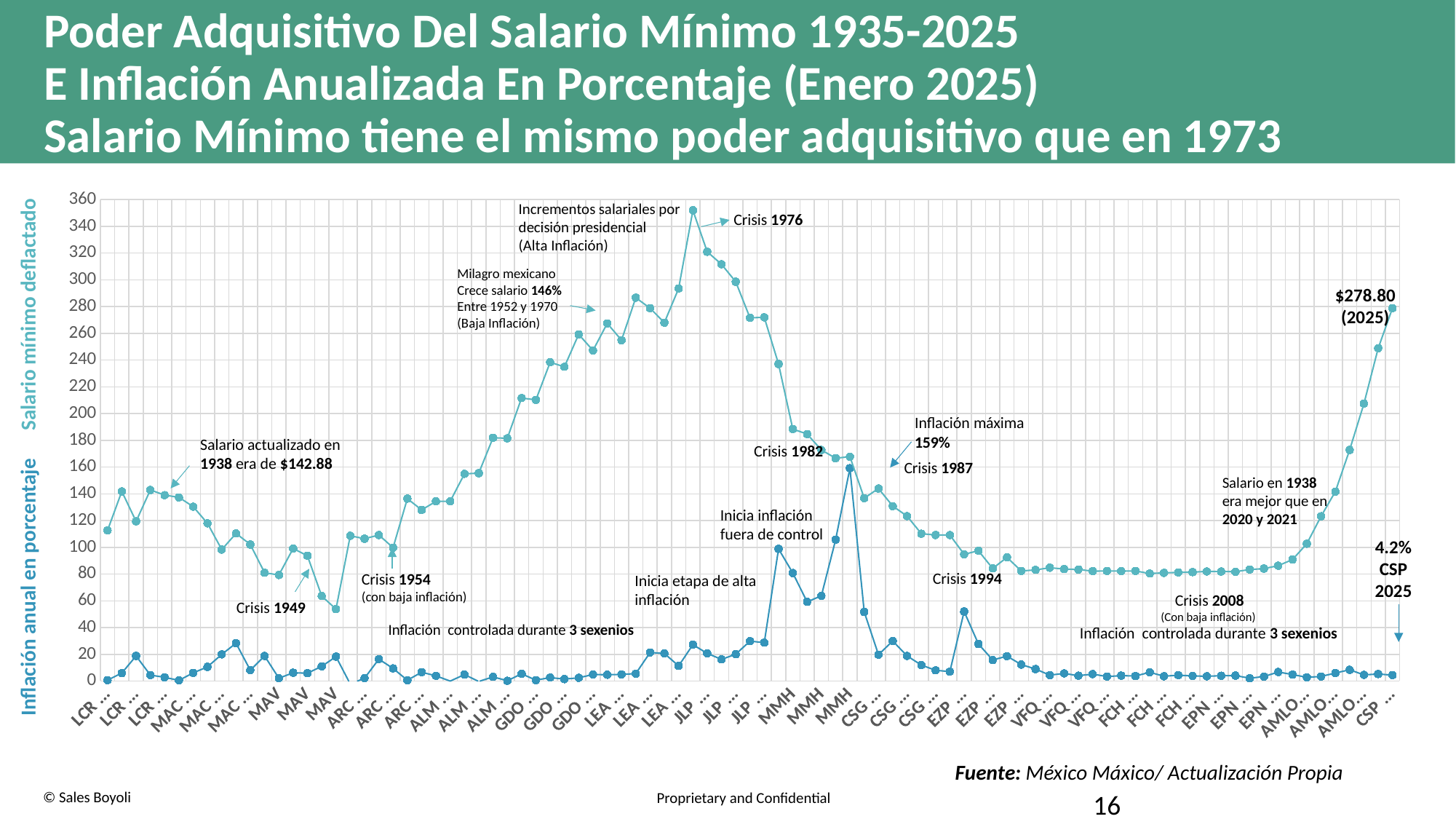
What kind of chart is shown on the slide? Line chart How many data series are plotted on the chart? 2 What annual inflation percentage is labelled for CSP 2025? 4.2% What is the maximum inflation value annotated on the chart? 159% Is the peak of the deflated minimum wage line near Crisis 1976 greater or less than 340? greater What is the difference between the deflated minimum wage in 2025 ($278.80) and the 1938 salary ($142.88)? $135.92 Which is larger, the deflated minimum wage in 2025 or the salary in 1938? 2025 Is the deflated minimum wage during the VFQ period greater or less than 100? less What is the highest value shown on the vertical axis? 360 What is the deflated minimum wage value labelled for 2025 on the chart? $278.80 According to the annotation, what was the updated salary in 1938? $142.88 Does the deflated minimum wage line rise or fall from the AMLO period to CSP? rise